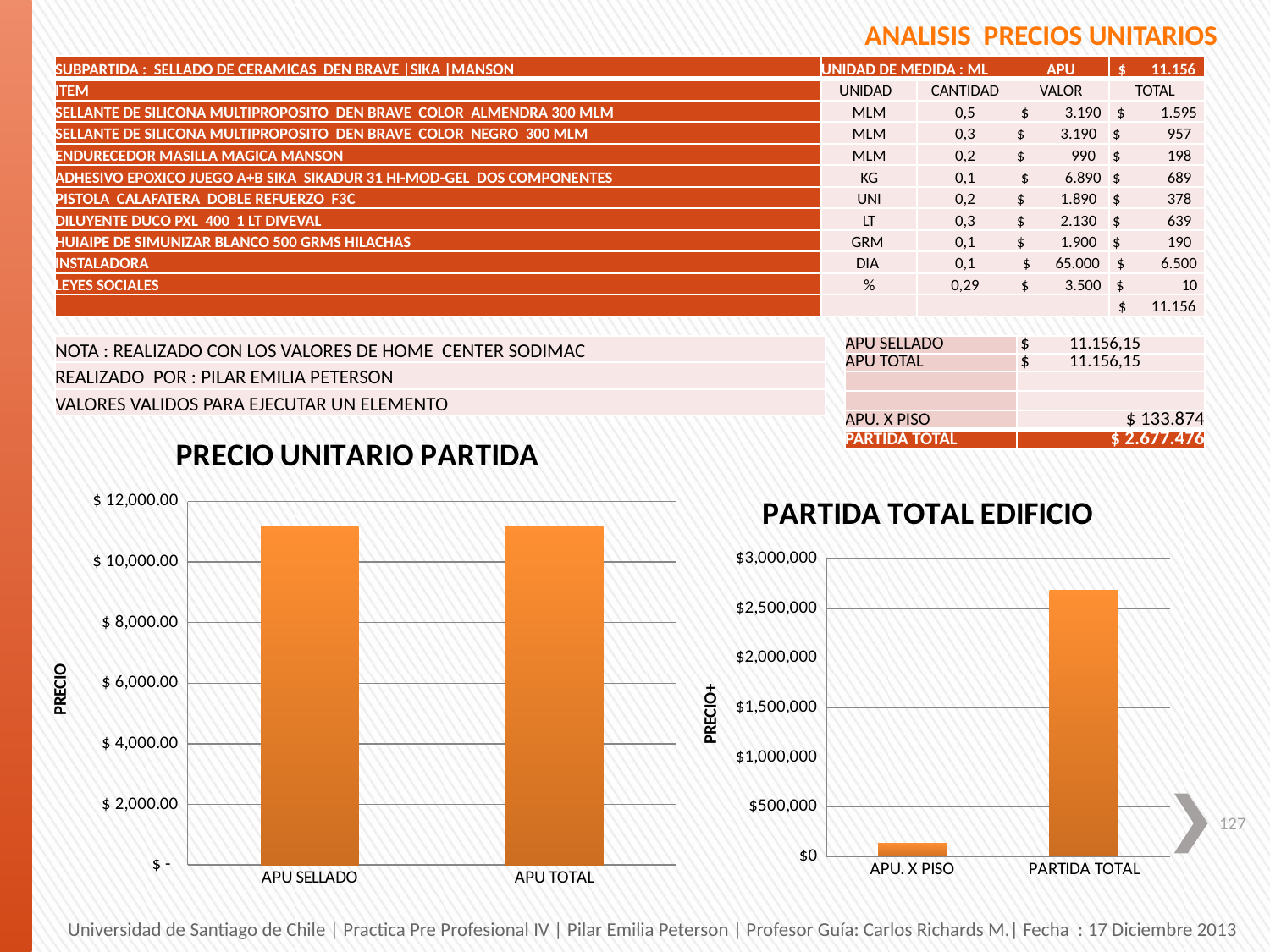
In the "PARTIDA TOTAL EDIFICIO" chart, which category has the lowest value? APU. X PISO In the "PRECIO UNITARIO PARTIDA" chart, is the value for APU SELLADO greater or less than $10,000.00? greater What is the y-axis title of the "PRECIO UNITARIO PARTIDA" chart? PRECIO How many categories are plotted in the "PARTIDA TOTAL EDIFICIO" chart? 2 What kind of chart is the "PRECIO UNITARIO PARTIDA" chart on the left? bar chart In the "PARTIDA TOTAL EDIFICIO" chart, is the value for APU. X PISO greater or less than $500,000? less In the "PARTIDA TOTAL EDIFICIO" chart, which category has the highest value? PARTIDA TOTAL In the "PARTIDA TOTAL EDIFICIO" chart, is the value for PARTIDA TOTAL greater or less than $2,500,000? greater In the "PARTIDA TOTAL EDIFICIO" chart, which is larger: APU. X PISO or PARTIDA TOTAL? PARTIDA TOTAL What kind of chart is the "PARTIDA TOTAL EDIFICIO" chart on the right? bar chart How many categories are plotted in the "PRECIO UNITARIO PARTIDA" chart? 2